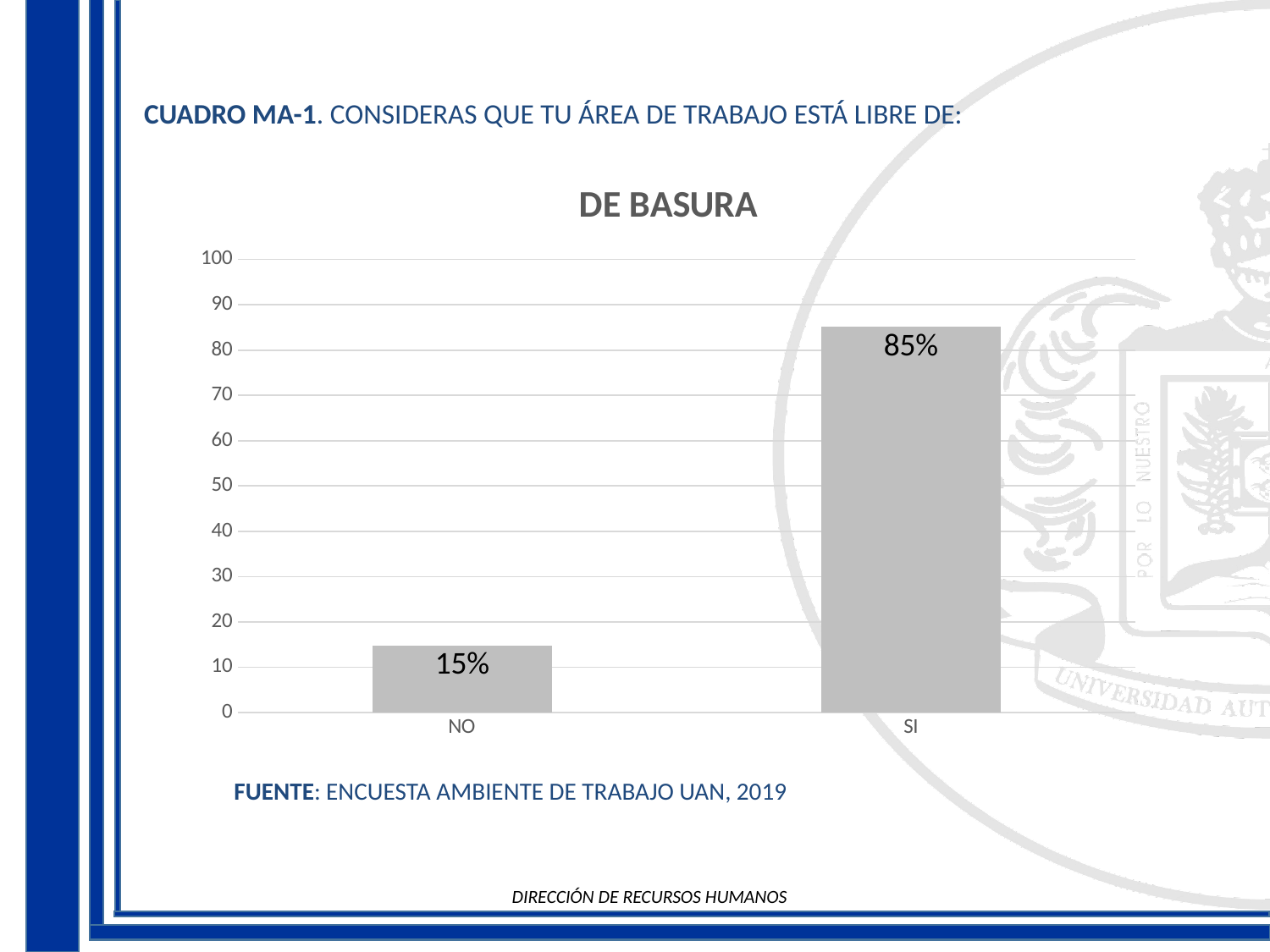
How many categories are shown on the x axis? 2 What is the value for SI? 85% Which category has the lowest value? NO What is the highest value shown on the y axis? 100 What is the title of the chart? DE BASURA Is the value for SI greater or less than 80? greater What kind of chart is shown? bar chart What is the value for NO? 15% What is the difference between the values for SI and NO? 70% Is the value for NO greater or less than 20? less Which is larger, the value for NO or the value for SI? SI Which category has the highest value? SI